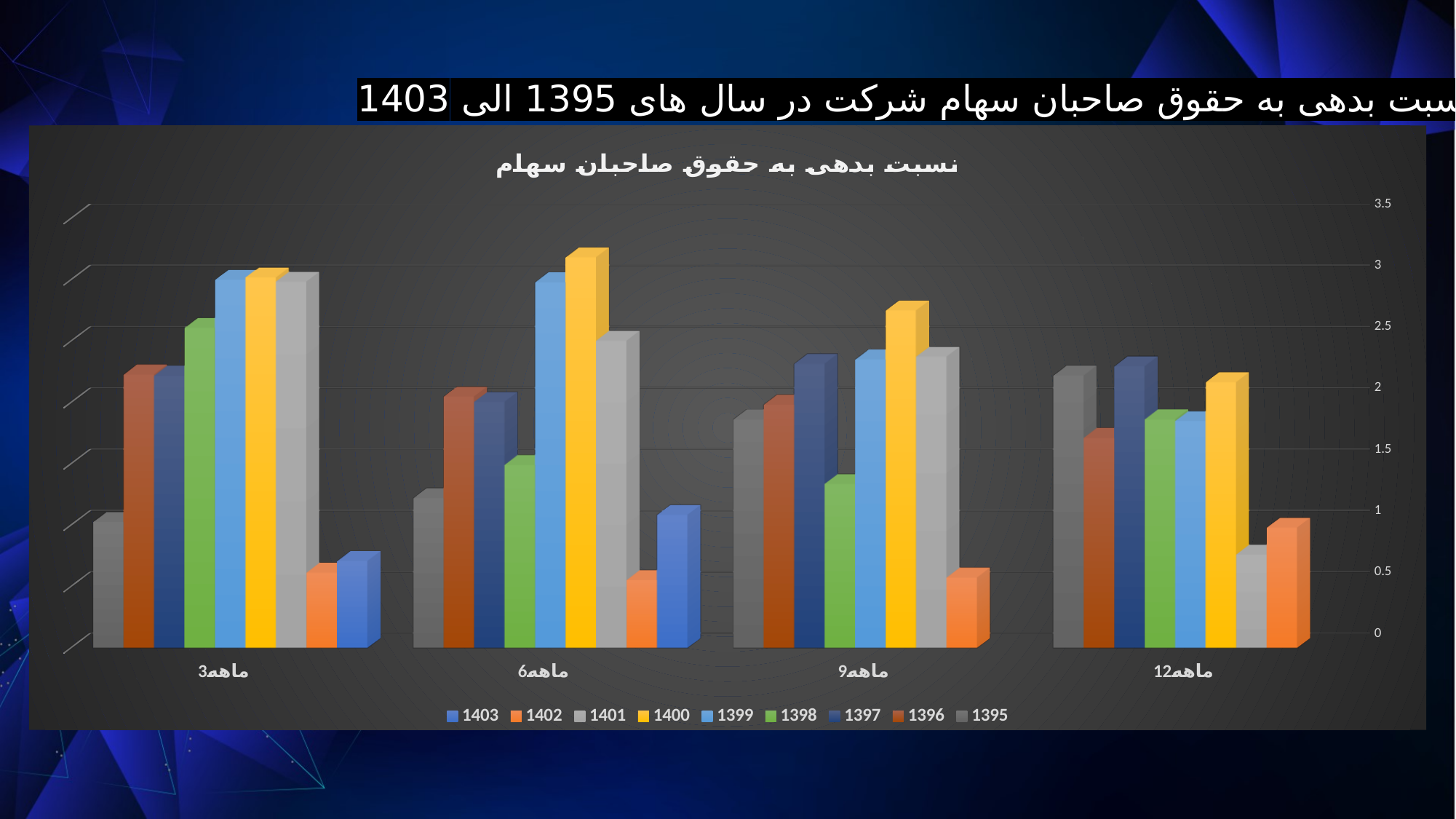
Which series has the highest value in the 6 ماهه category? 1400 What kind of chart is shown on the slide? bar chart How many categories are shown on the x axis? 4 Is the value for 1400 in the 6 ماهه category greater or less than 3? greater How many series does the legend list? 9 Which is larger: the value for 1400 in 6 ماهه or the value for 1400 in 12 ماهه? 6 ماهه Which series has the lowest value in the 12 ماهه category? 1401 Which series has the highest value in the 9 ماهه category? 1400 What is the title of the chart? نسبت بدهی به حقوق صاحبان سهام Which series has the lowest value in the 6 ماهه category? 1402